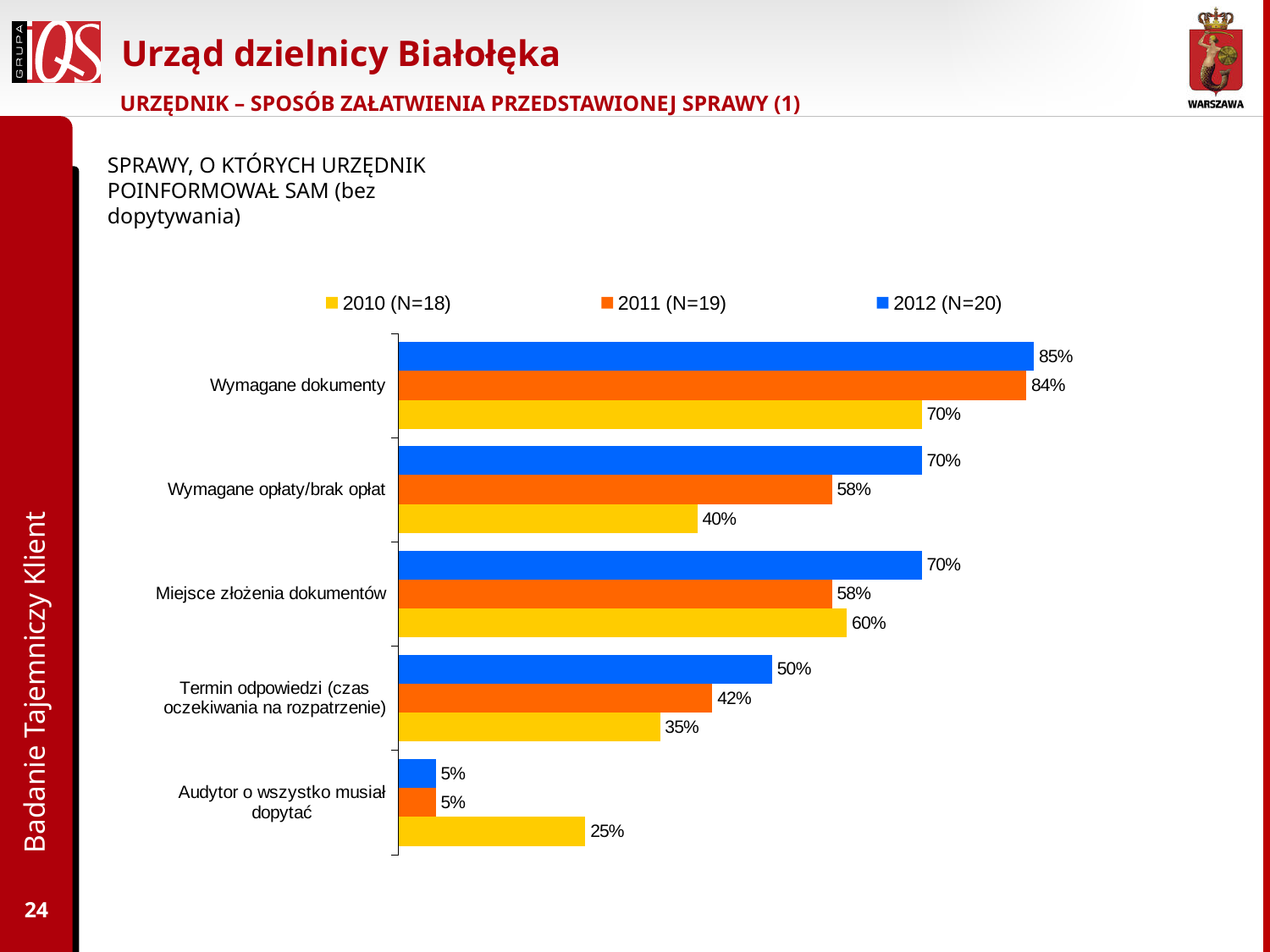
What is the value for Wymagane opłaty/brak opłat in the 2010 (N=18) series? 40% What kind of chart is shown on the slide? Bar chart How many categories are shown on the chart? 5 Which colour represents the 2011 (N=19) series? Orange Which category has the highest value in the 2012 (N=20) series? Wymagane dokumenty What is the value for Audytor o wszystko musiał dopytać in the 2010 (N=18) series? 25% What is the value for Termin odpowiedzi (czas oczekiwania na rozpatrzenie) in the 2011 (N=19) series? 42% Which is larger for Miejsce złożenia dokumentów: the 2010 (N=18) value or the 2011 (N=19) value? 2010 (N=18) What is the value for Wymagane dokumenty in the 2012 (N=20) series? 85% What is the difference between the 2012 (N=20) and 2010 (N=18) values for Wymagane opłaty/brak opłat? 30% Which category has the lowest value in the 2011 (N=19) series? Audytor o wszystko musiał dopytać How many series does the legend list? 3